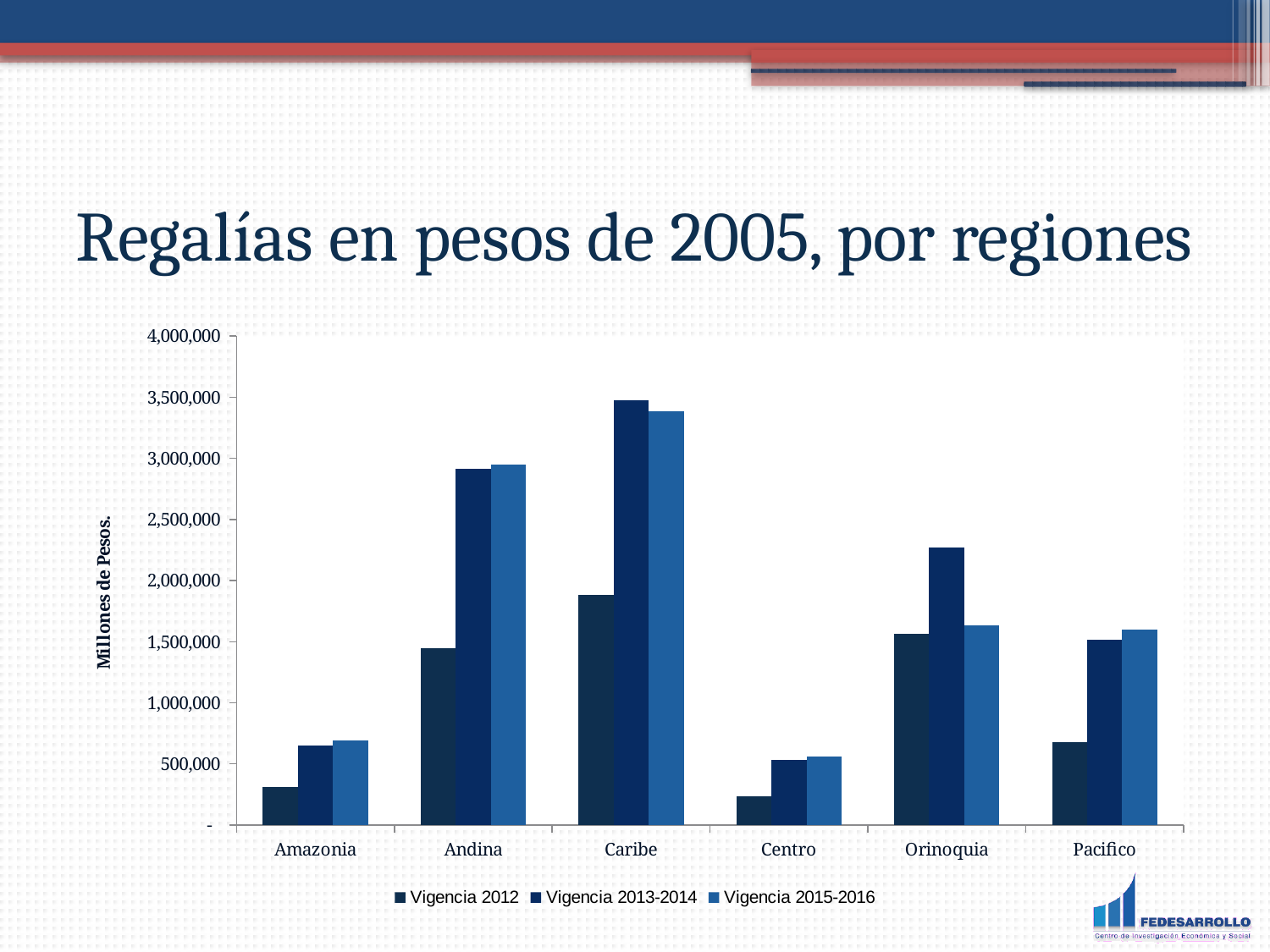
Which region has the lowest Vigencia 2012 bar? Centro Which has the larger Vigencia 2015-2016 value, Andina or Caribe? Caribe What kind of chart is shown on the slide? Bar chart Is the Vigencia 2012 value for Andina greater or less than 1,000,000? greater What is the label on the vertical axis? Millones de Pesos. Which region has the highest Vigencia 2013-2014 bar? Caribe For Orinoquia, which is larger: the Vigencia 2013-2014 value or the Vigencia 2015-2016 value? Vigencia 2013-2014 What is the title of the slide? Regalías en pesos de 2005, por regiones Is the Vigencia 2013-2014 value for Caribe greater or less than 3,000,000? greater How many regions are shown on the x axis? 6 Is the Vigencia 2012 value for Amazonia greater or less than 500,000? less How many series does the legend list? 3